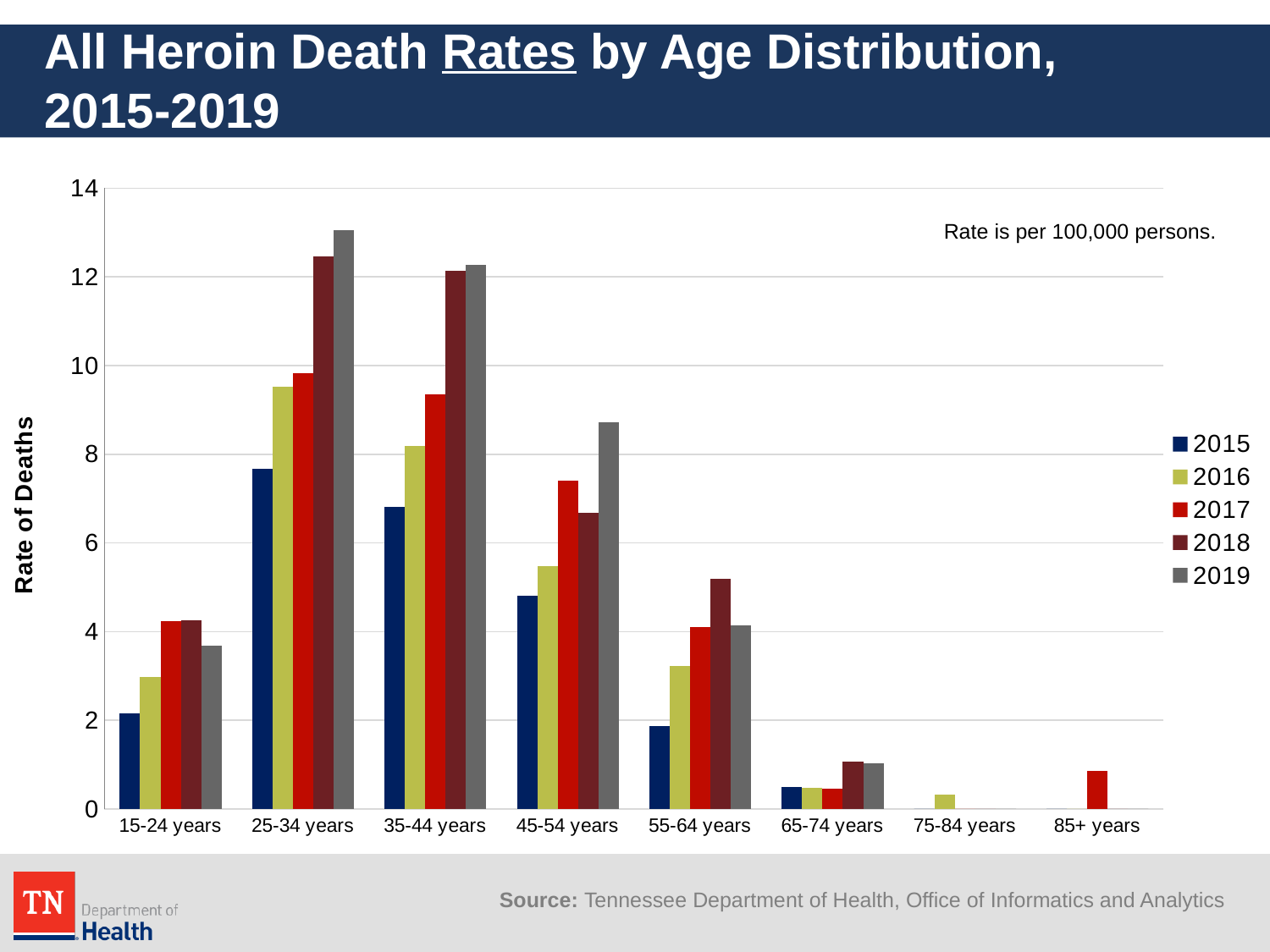
Is the 2019 value for 25-34 years greater or less than 12? greater How many age groups are shown on the x axis? 8 Which year has the lowest bar in the 55-64 years group? 2015 Is the 2016 value for 15-24 years greater or less than 4? less Which age group has the highest 2019 bar? 25-34 years For 55-64 years, which is larger, the 2018 value or the 2019 value? 2018 For 45-54 years, which is larger, the 2017 value or the 2018 value? 2017 Do the values for 25-34 years rise or fall from 2015 to 2019? rise How many series does the legend list? 5 Is the 2015 value for 35-44 years greater or less than 6? greater What kind of chart is shown on the slide? Bar chart According to the note on the chart, the rate is per how many persons? 100,000 persons